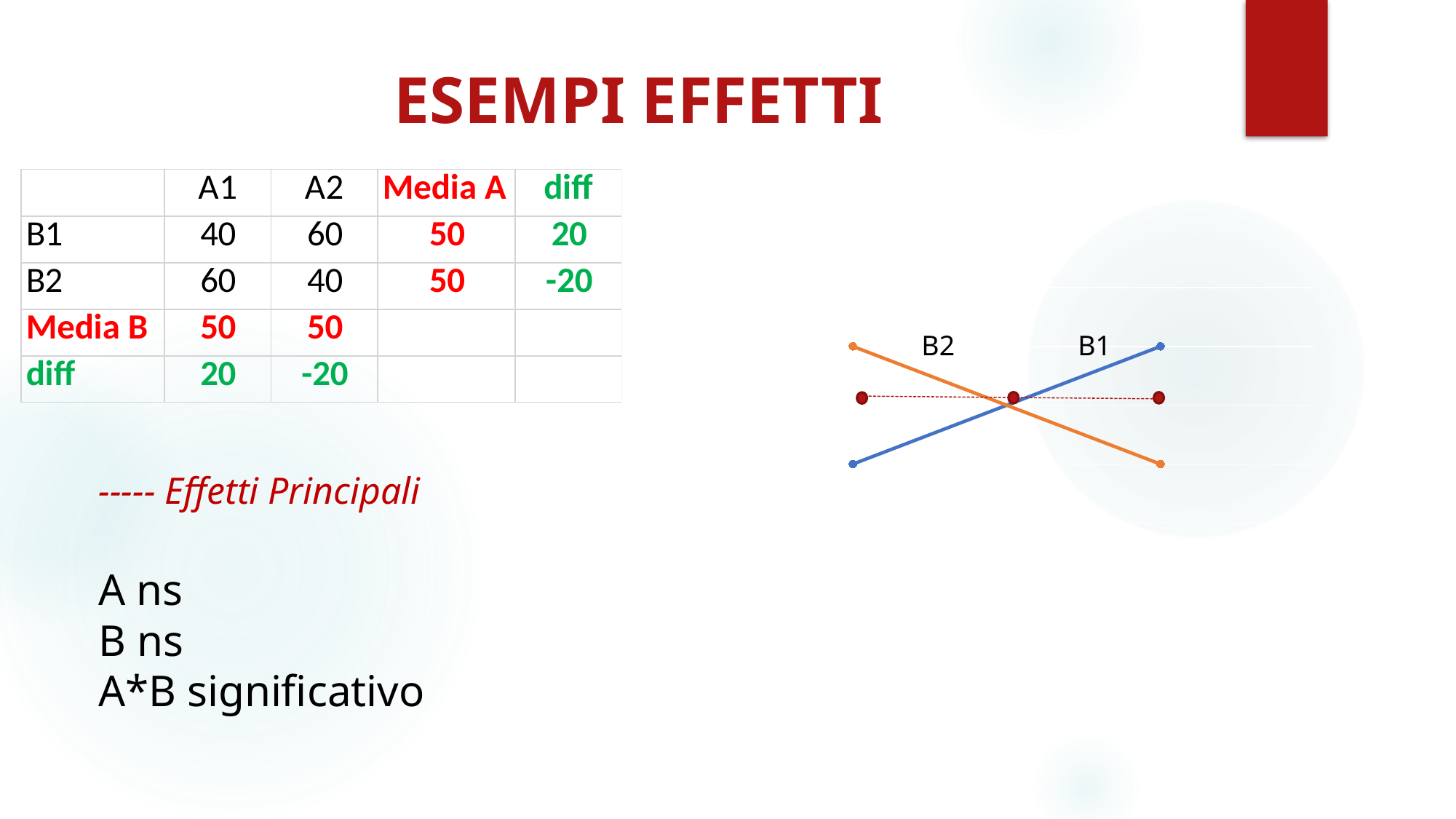
What kind of chart is shown on the right of the slide? line chart According to the slide, what does the dashed line in the chart represent? Effetti Principali Do the B1 and B2 lines cross each other? yes Does the B2 line rise or fall from left to right? falls Does the B1 line rise or fall from left to right? rises What colour is the B1 line in the chart? blue At the right end of the chart, which line is higher, B1 or B2? B1 How many points are plotted on the dashed red line? 3 Does the dashed red line rise, fall or stay level from left to right? stays level How many labelled lines (B1, B2) does the chart plot? 2 How many points are plotted on the B1 line? 2 At the left end of the chart, which line is higher, B1 or B2? B2